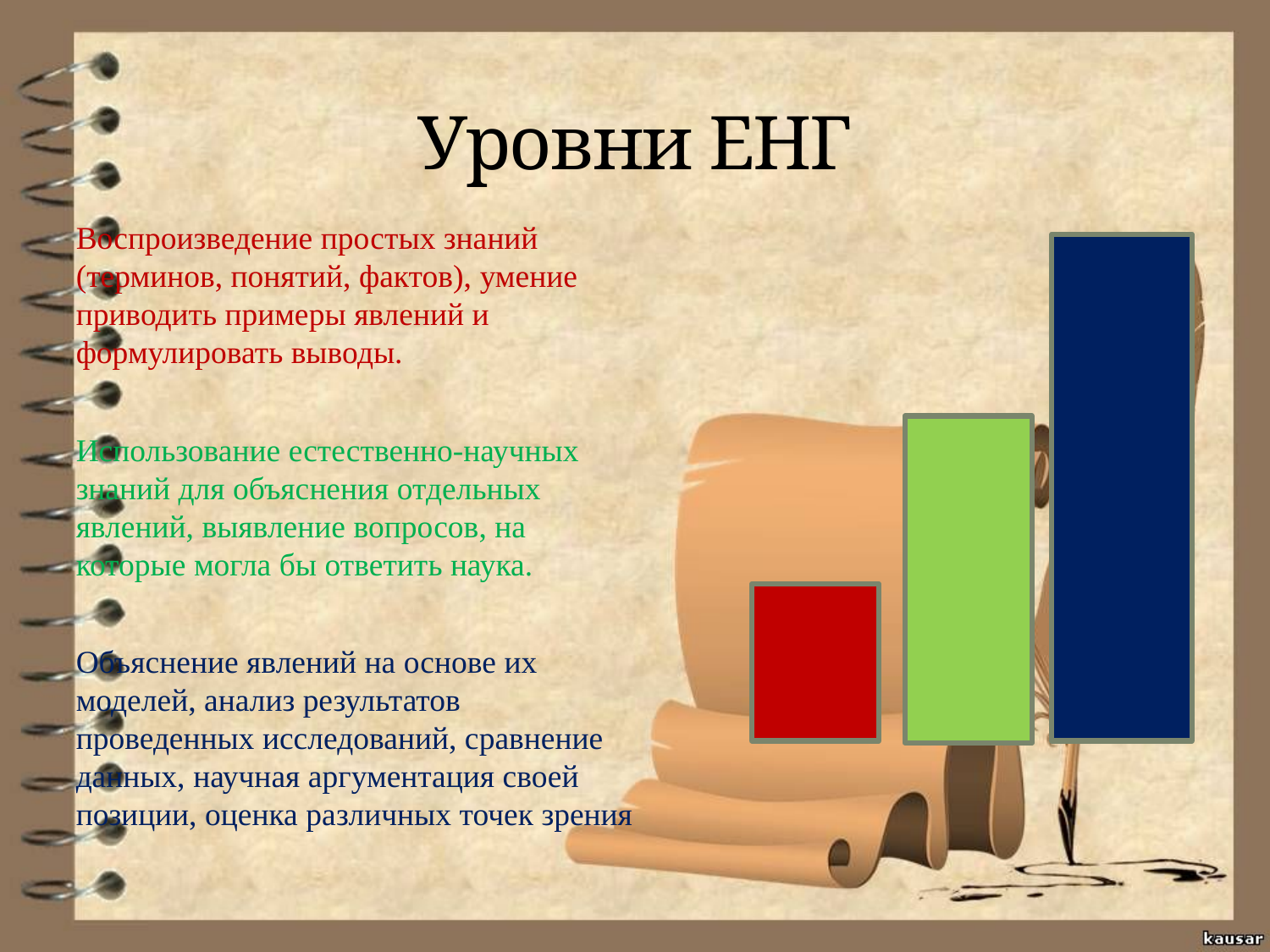
What is the title of the slide containing the chart? Уровни ЕНГ Which bar is taller, the blue bar or the green bar? the blue bar What kind of chart is shown on the right side of the slide? bar chart What colours are the three bars in the chart, from left to right? red, green, blue Which bar is taller, the green bar or the red bar? the green bar How many bars does the chart on the slide contain? 3 Which bar in the chart is the shortest? the red bar Do the bars in the chart rise or fall from left to right? rise Which bar in the chart is the tallest? the blue bar